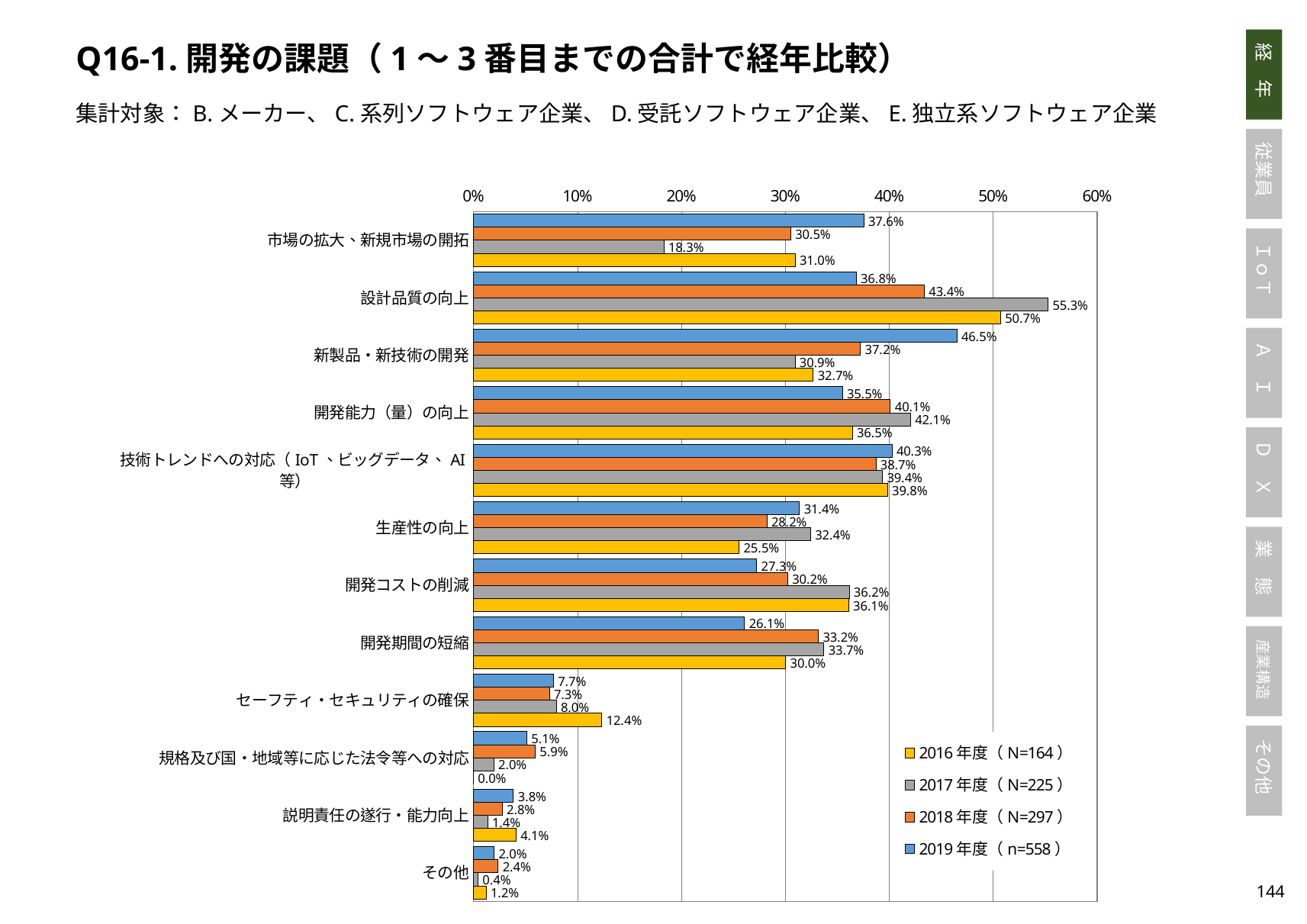
How many categories are plotted on the chart? 12 How many series does the legend list? 4 What is the difference between the 2017年度 and 2019年度 values for 設計品質の向上? 18.5% What type of chart is shown on the slide? bar chart Which is larger for 開発コストの削減: the 2019年度 value or the 2017年度 value? 2017年度 Which category has the lowest value in 2016年度? 規格及び国・地域等に応じた法令等への対応 Which category has the highest value in 2019年度? 新製品・新技術の開発 Is the 2016年度 value for セーフティ・セキュリティの確保 greater or less than 10%? greater What is the value for 設計品質の向上 in 2017年度? 55.3% What is the value for 新製品・新技術の開発 in 2019年度? 46.5% What sample size (N) does the legend give for 2019年度? n=558 What is the value for 市場の拡大、新規市場の開拓 in 2017年度? 18.3%